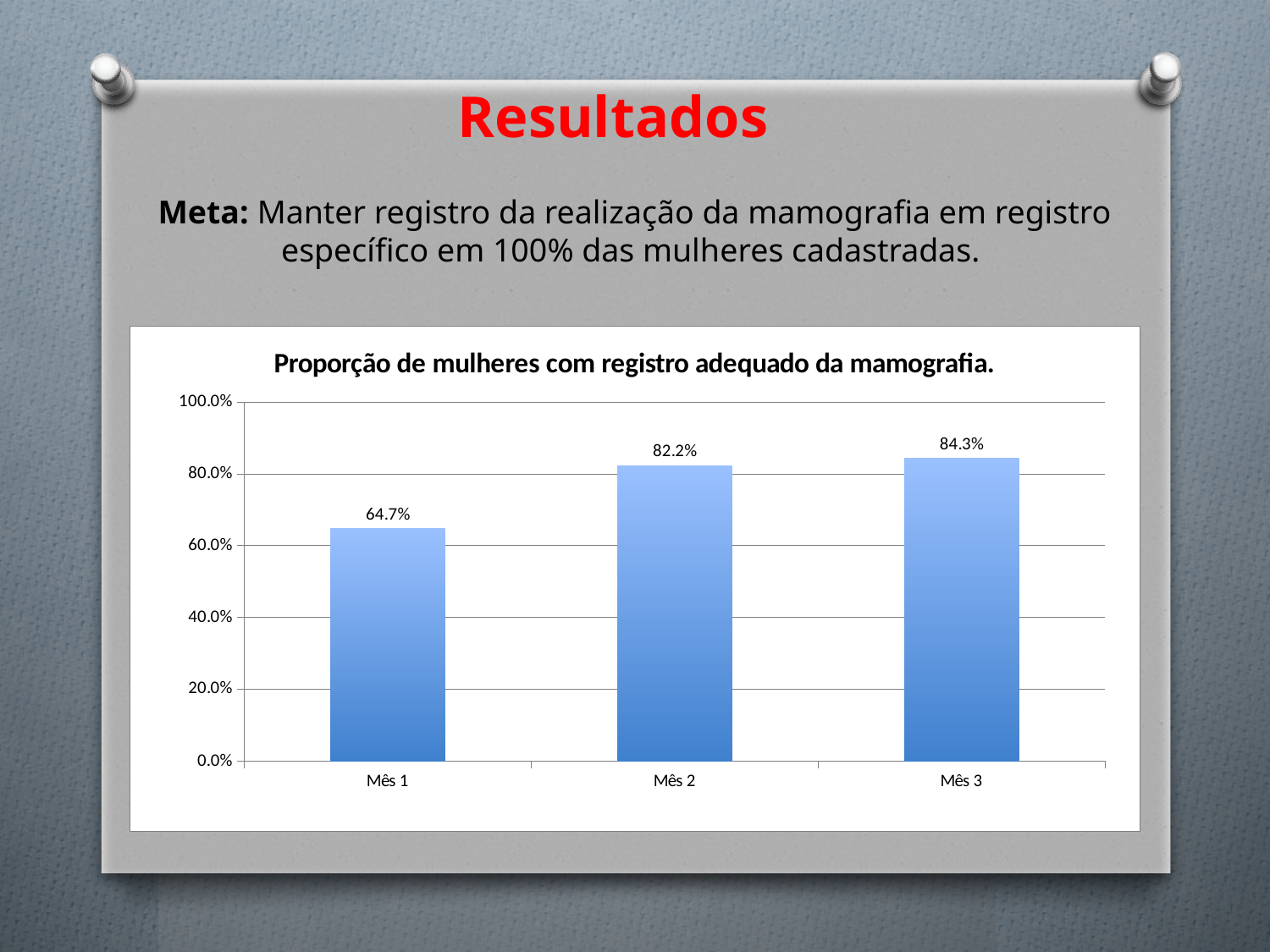
What is the value for Mês 2? 82.2% How many months are shown on the x axis? 3 What is the difference between the values for Mês 2 and Mês 1? 17.5% Do the values rise or fall from Mês 1 to Mês 3? rise Is the value for Mês 1 greater or less than 80.0%? less What is the value for Mês 1? 64.7% What is the difference between the values for Mês 3 and Mês 2? 2.1% What kind of chart is shown on the slide? bar chart Which month has the lowest value? Mês 1 Which month has the highest value? Mês 3 Which is larger, the value for Mês 1 or the value for Mês 2? Mês 2 What is the value for Mês 3? 84.3%